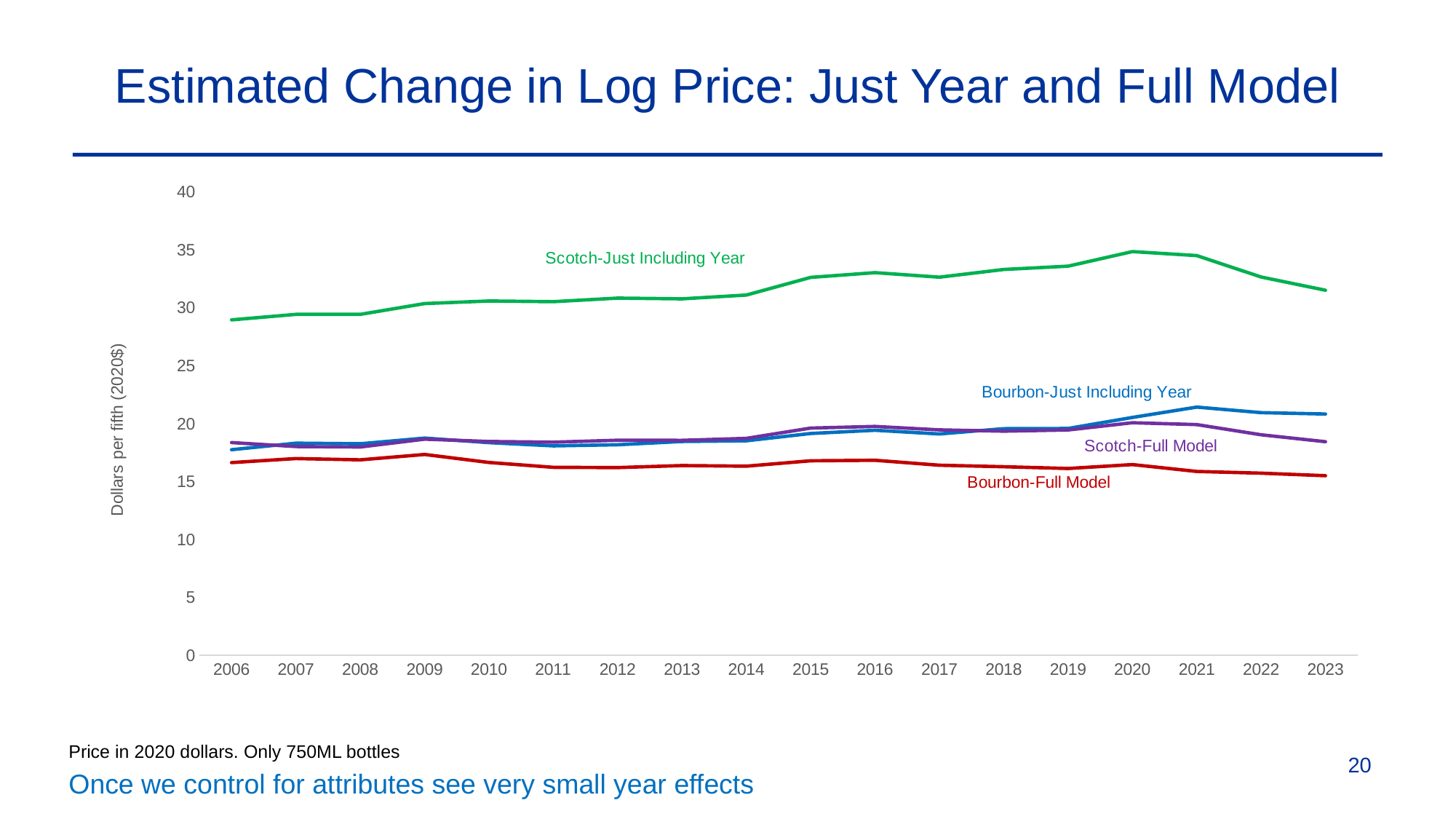
What is the label on the vertical axis of the chart? Dollars per fifth (2020$) How many years are shown along the x axis of the chart? 18 In 2015, which is larger: Scotch-Just Including Year or Bourbon-Full Model? Scotch-Just Including Year How many data series are plotted on the chart? 4 In which year does the Scotch-Just Including Year series reach its highest value? 2020 Which series has the highest values across the whole chart? Scotch-Just Including Year Is the value for Scotch-Just Including Year in 2020 greater or less than 30? greater What kind of chart is shown on the slide? line chart Does the Scotch-Just Including Year series generally rise or fall from 2006 to 2020? rise Which series has the lowest values across the whole chart? Bourbon-Full Model Is the value for Bourbon-Full Model in 2023 greater or less than 20? less Is the value for Bourbon-Just Including Year in 2021 greater or less than 20? greater